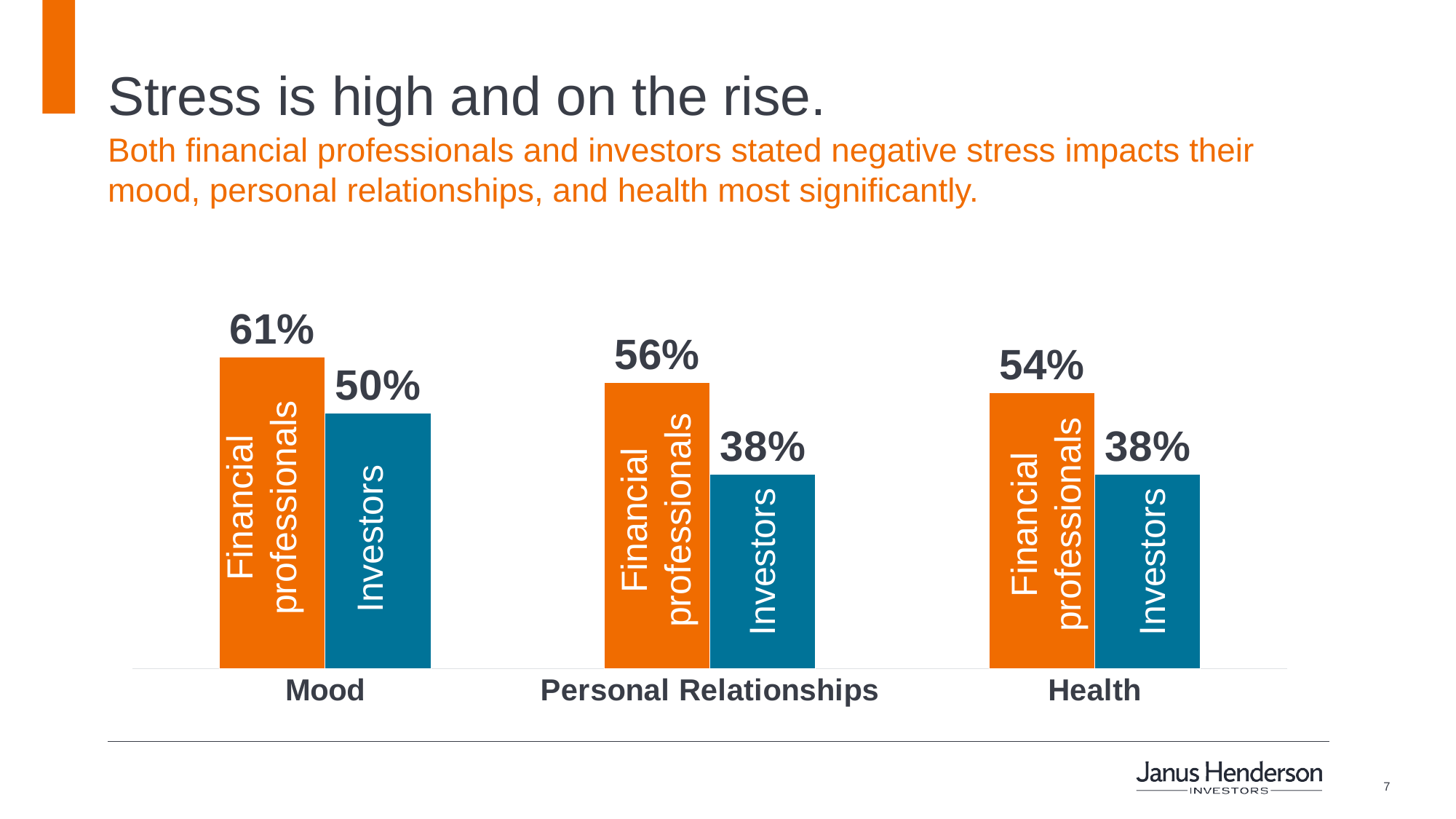
How many series are plotted in the chart? 2 Which category has the highest value for financial professionals? Mood What is the value for investors in the Mood category? 50% What percentage of financial professionals said stress impacts their mood? 61% What kind of chart is shown on the slide? Bar chart Which category has the lowest value for financial professionals? Health What percentage of investors said stress impacts their personal relationships? 38% Which is larger in the Health category: financial professionals or investors? Financial professionals What is the difference between financial professionals and investors in the Mood category? 11% How many categories are shown on the x axis? 3 What is the difference between financial professionals and investors in the Personal Relationships category? 18% What is the value for financial professionals in the Health category? 54%